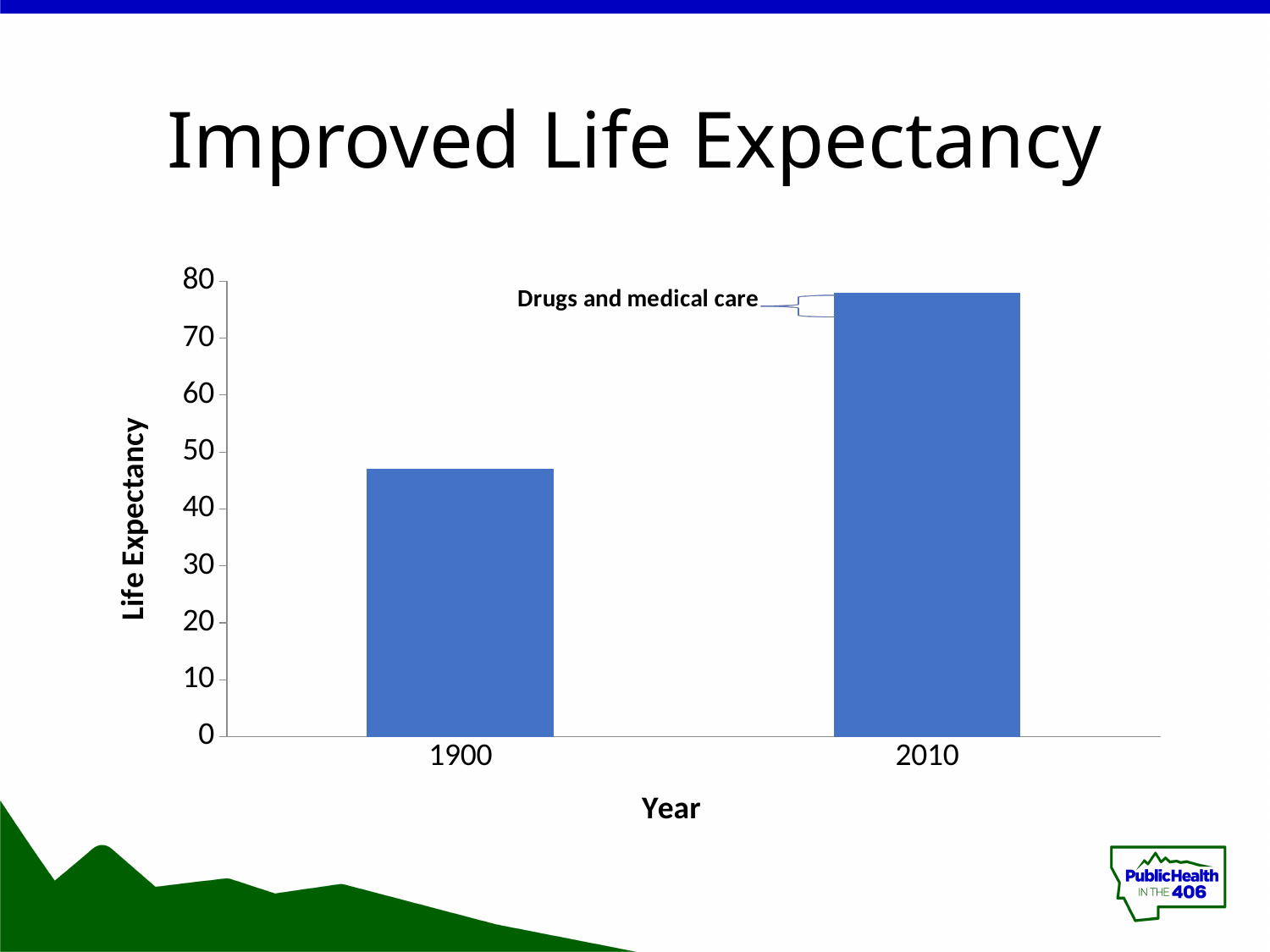
Is the life expectancy for 2010 greater or less than 70? greater Is the bar for 2010 taller or shorter than the bar for 1900? taller Is the life expectancy for 1900 greater or less than 40? greater What kind of chart is shown on the slide? bar chart Which year has the higher life expectancy in the chart? 2010 Does life expectancy rise or fall from 1900 to 2010 in the chart? rise Which year has the lower life expectancy in the chart? 1900 What is the label on the vertical axis of the chart? Life Expectancy What annotation text points to the 2010 bar in the chart? Drugs and medical care Is the life expectancy for 2010 greater or less than 80? less How many bars are plotted in the chart? 2